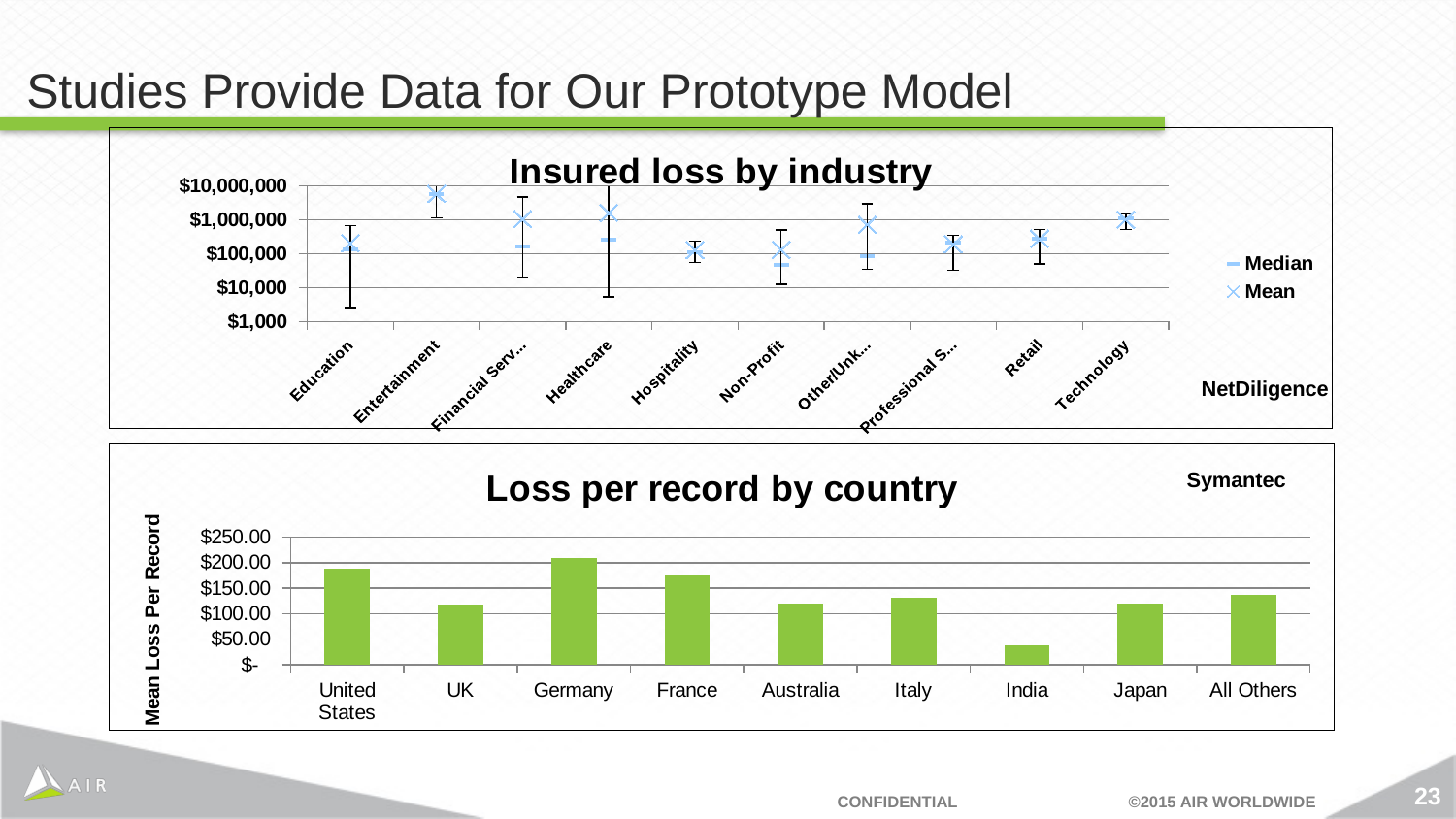
In the 'Loss per record by country' chart, is the value for India greater or less than $50.00? less In the 'Insured loss by industry' chart, is the mean value for Entertainment greater or less than $1,000,000? greater What kind of chart is 'Loss per record by country'? Bar chart How many series does the legend of the 'Insured loss by industry' chart list? 2 How many countries/categories are shown in the 'Loss per record by country' chart? 9 In the 'Loss per record by country' chart, which has the larger value, United States or UK? United States In the 'Loss per record by country' chart, which country has the highest mean loss per record? Germany In the 'Loss per record by country' chart, is the value for United States greater or less than $150.00? greater What is the y-axis label of the 'Loss per record by country' chart? Mean Loss Per Record In the 'Loss per record by country' chart, which country has the lowest mean loss per record? India How many industries are shown on the x axis of the 'Insured loss by industry' chart? 10